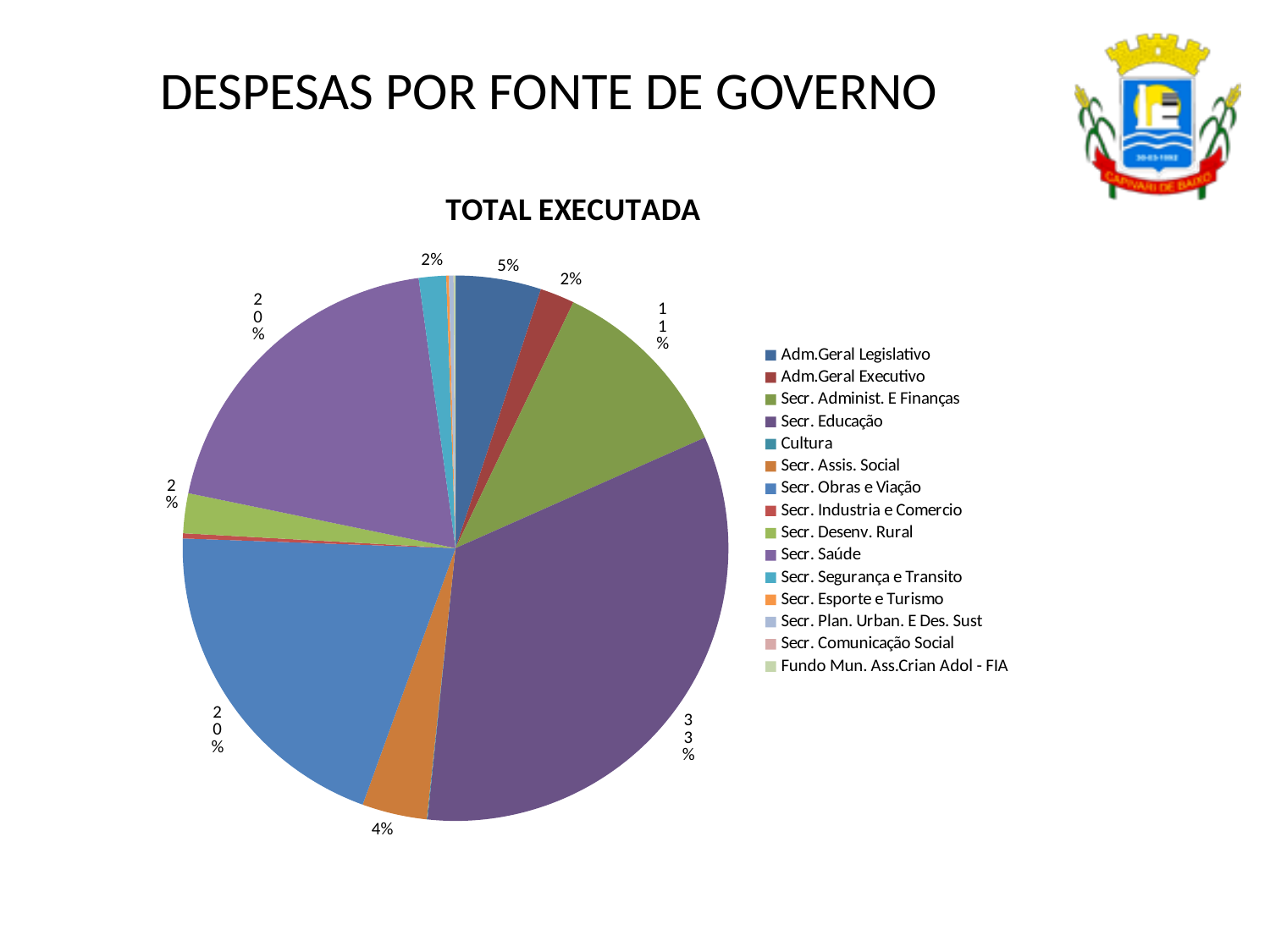
Which is larger, the share for Secr. Educação or the share for Secr. Obras e Viação? Secr. Educação What is the difference between the share for Secr. Educação and the share for Secr. Saúde? 13% What is the title of the chart? TOTAL EXECUTADA What share of the pie does Secr. Educação have? 33% What kind of chart is shown on the slide? pie chart Which category has the largest share of the pie? Secr. Educação What share of the pie does Secr. Administ. E Finanças have? 11% How many entries does the chart legend list? 15 What share of the pie does Secr. Assis. Social have? 4%